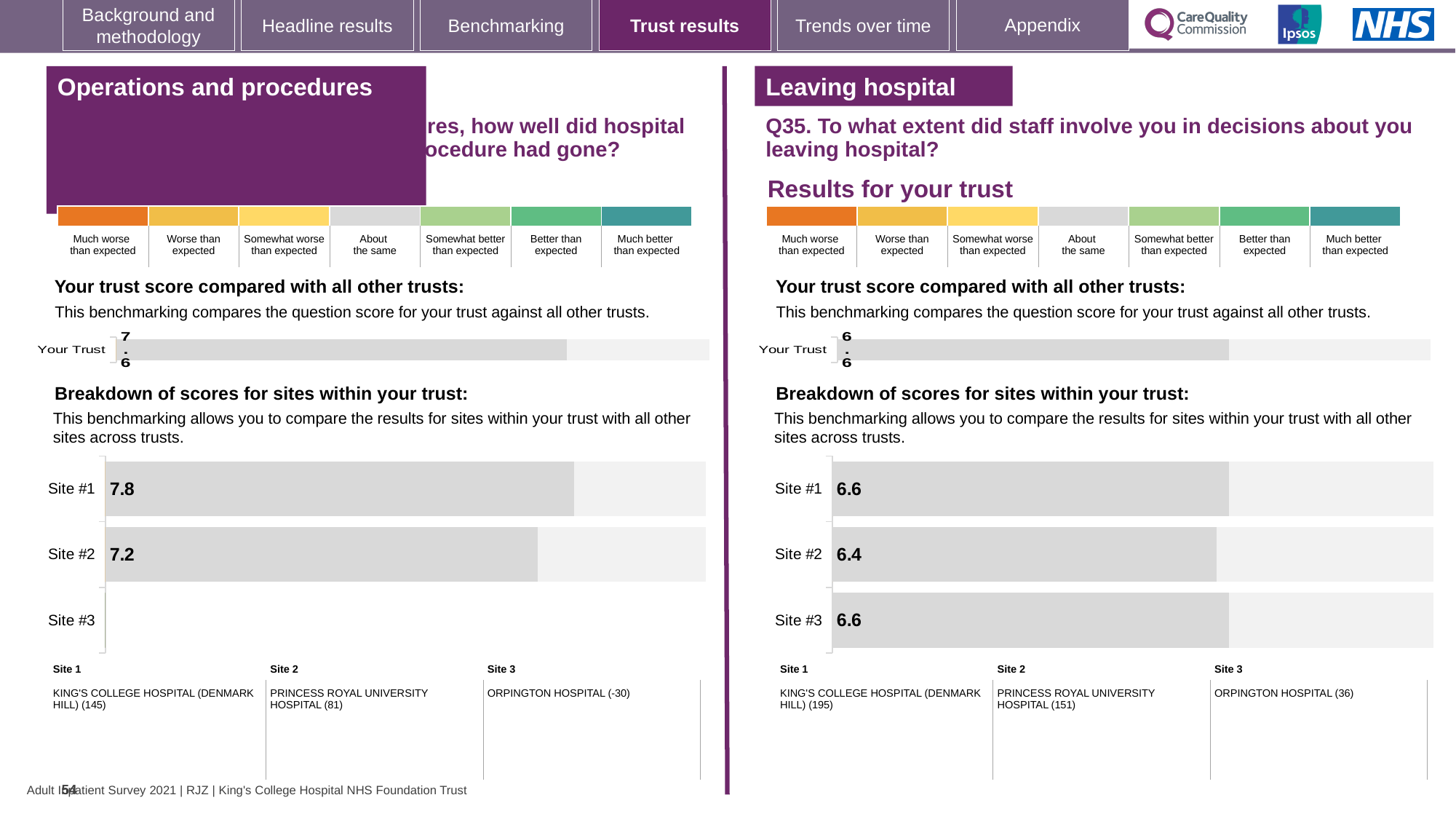
In the 'Leaving hospital' 'Your Trust' chart on the right, what is the trust score? 6.6 In the 'Operations and procedures' site breakdown chart on the left, what is the score for Site #2? 7.2 In the 'Leaving hospital' site breakdown chart on the right, what is the score for Site #1? 6.6 In the 'Operations and procedures' site breakdown chart on the left, which site has the higher score, Site #1 or Site #2? Site #1 In the 'Leaving hospital' site breakdown chart on the right, what is the score for Site #2? 6.4 In the 'Operations and procedures' site breakdown chart on the left, what is the difference between the scores for Site #1 and Site #2? 0.6 In the 'Leaving hospital' site breakdown chart on the right, which site has the lowest score? Site #2 In the 'Leaving hospital' site breakdown chart on the right, what is the difference between the scores for Site #1 and Site #2? 0.2 In the 'Operations and procedures' site breakdown chart on the left, what is the score for Site #1? 7.8 In the 'Operations and procedures' 'Your Trust' chart on the left, what is the trust score? 7.6 What type of chart is used for the site breakdown of scores on the right side of the slide? Bar chart How many sites are listed in the 'Leaving hospital' site breakdown chart on the right? 3